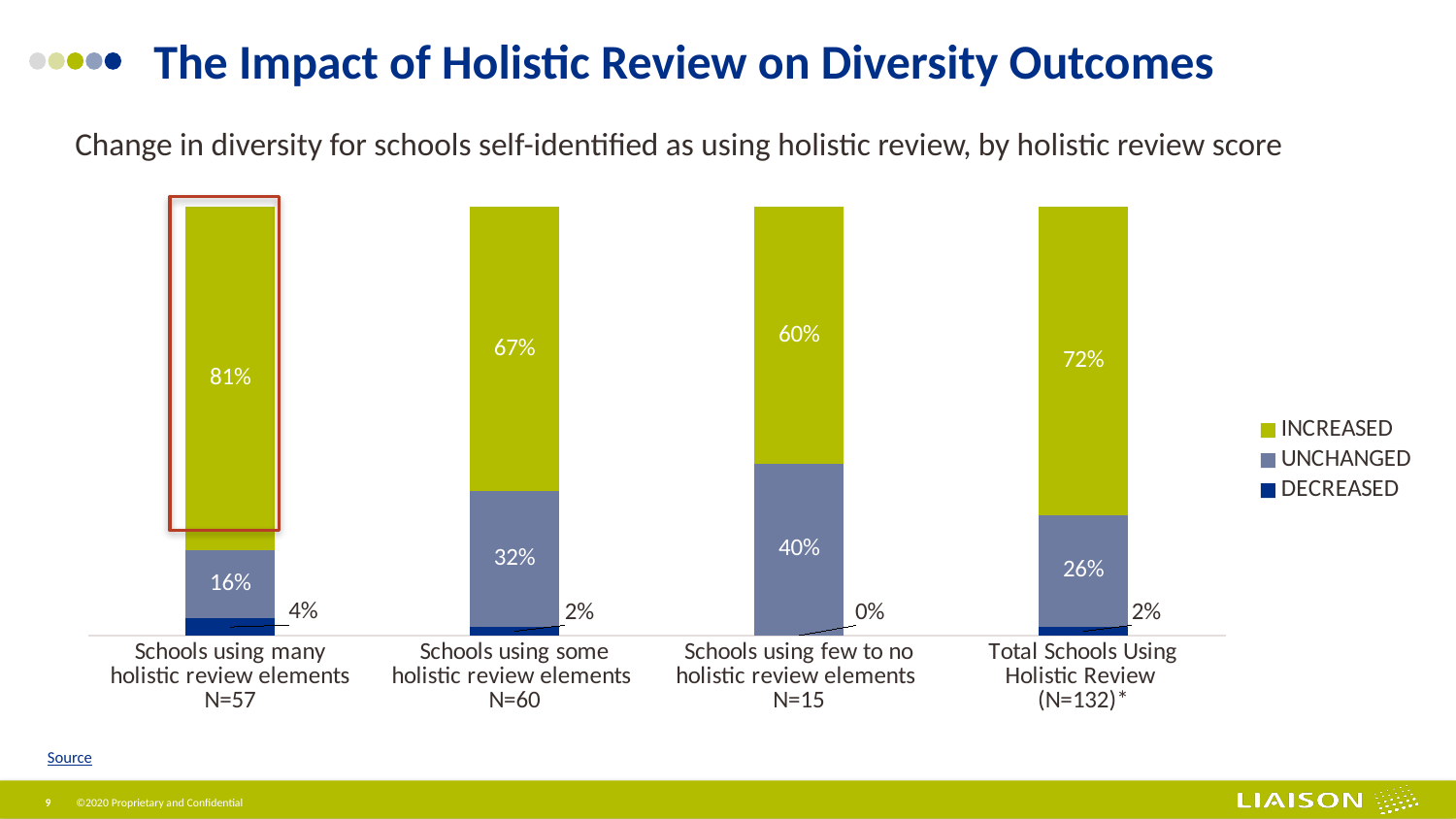
What kind of chart is shown on the slide? Stacked bar chart Which is larger: the UNCHANGED value for schools using some holistic review elements or for Total Schools Using Holistic Review? Schools using some holistic review elements What is the difference between the INCREASED values for schools using many holistic review elements and schools using few to no holistic review elements? 21% How many series does the legend list? 3 Which category has the lowest DECREASED percentage? Schools using few to no holistic review elements What is the UNCHANGED value for schools using few to no holistic review elements? 40% How many categories are shown on the x axis of the chart? 4 Which category has the highest INCREASED percentage? Schools using many holistic review elements What is the DECREASED value for Total Schools Using Holistic Review (N=132)*? 2% What is the INCREASED value for schools using some holistic review elements? 67% Which series is shown in dark blue in the legend? DECREASED What percentage of schools using many holistic review elements reported increased diversity? 81%